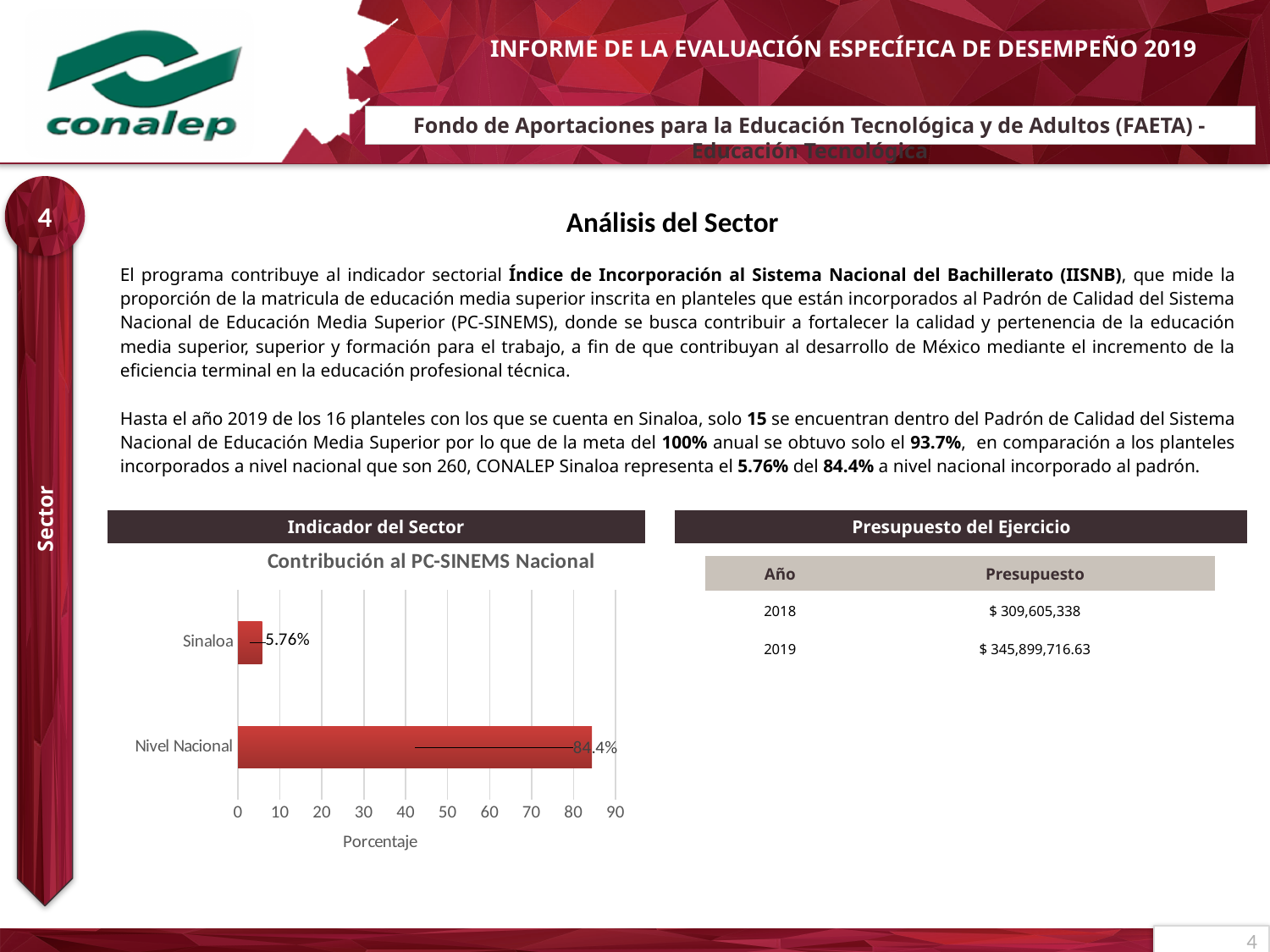
Is the value for Sinaloa in the Contribución al PC-SINEMS Nacional chart greater or less than 10? less Which category has the highest value in the Contribución al PC-SINEMS Nacional chart? Nivel Nacional Which category has the lowest value in the Contribución al PC-SINEMS Nacional chart? Sinaloa In the Contribución al PC-SINEMS Nacional chart, which is larger: Sinaloa or Nivel Nacional? Nivel Nacional What is the label of the horizontal axis in the Contribución al PC-SINEMS Nacional chart? Porcentaje Is the value for Nivel Nacional in the Contribución al PC-SINEMS Nacional chart greater or less than 80? greater What type of chart is the Contribución al PC-SINEMS Nacional chart? Bar chart What is the value for Nivel Nacional in the Contribución al PC-SINEMS Nacional chart? 84.4% What is the value for Sinaloa in the Contribución al PC-SINEMS Nacional chart? 5.76% What is the title of the chart on the slide? Contribución al PC-SINEMS Nacional What is the difference between the Nivel Nacional and Sinaloa values in the Contribución al PC-SINEMS Nacional chart? 78.64% How many categories are shown in the Contribución al PC-SINEMS Nacional chart? 2